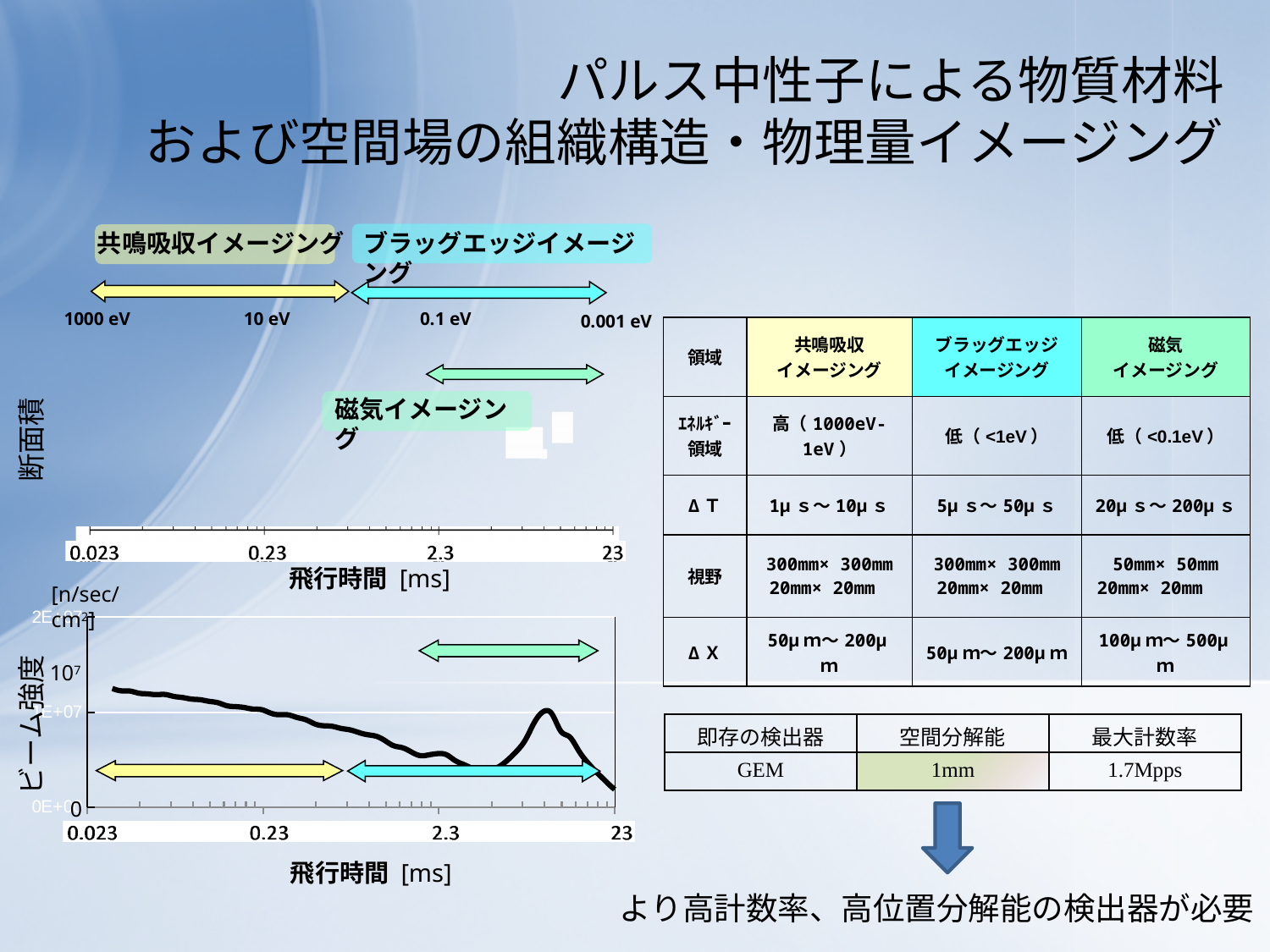
In the lower-left chart, is the beam intensity at 0.023 ms greater or less than the beam intensity at 2.3 ms? greater How many tick labels are printed on the x axis of the lower-left chart? 4 What kind of chart is the lower-left chart plotting ビーム強度 against 飛行時間? line chart In the lower-left chart, what unit is shown for the y axis (ビーム強度)? [n/sec/cm²] How many data series are plotted as lines in the lower-left chart? 1 In the lower-left chart, does the beam intensity rise or fall as flight time goes from 0.023 ms to 2.3 ms? fall In the lower-left chart, what is the label of the x axis? 飛行時間 [ms]